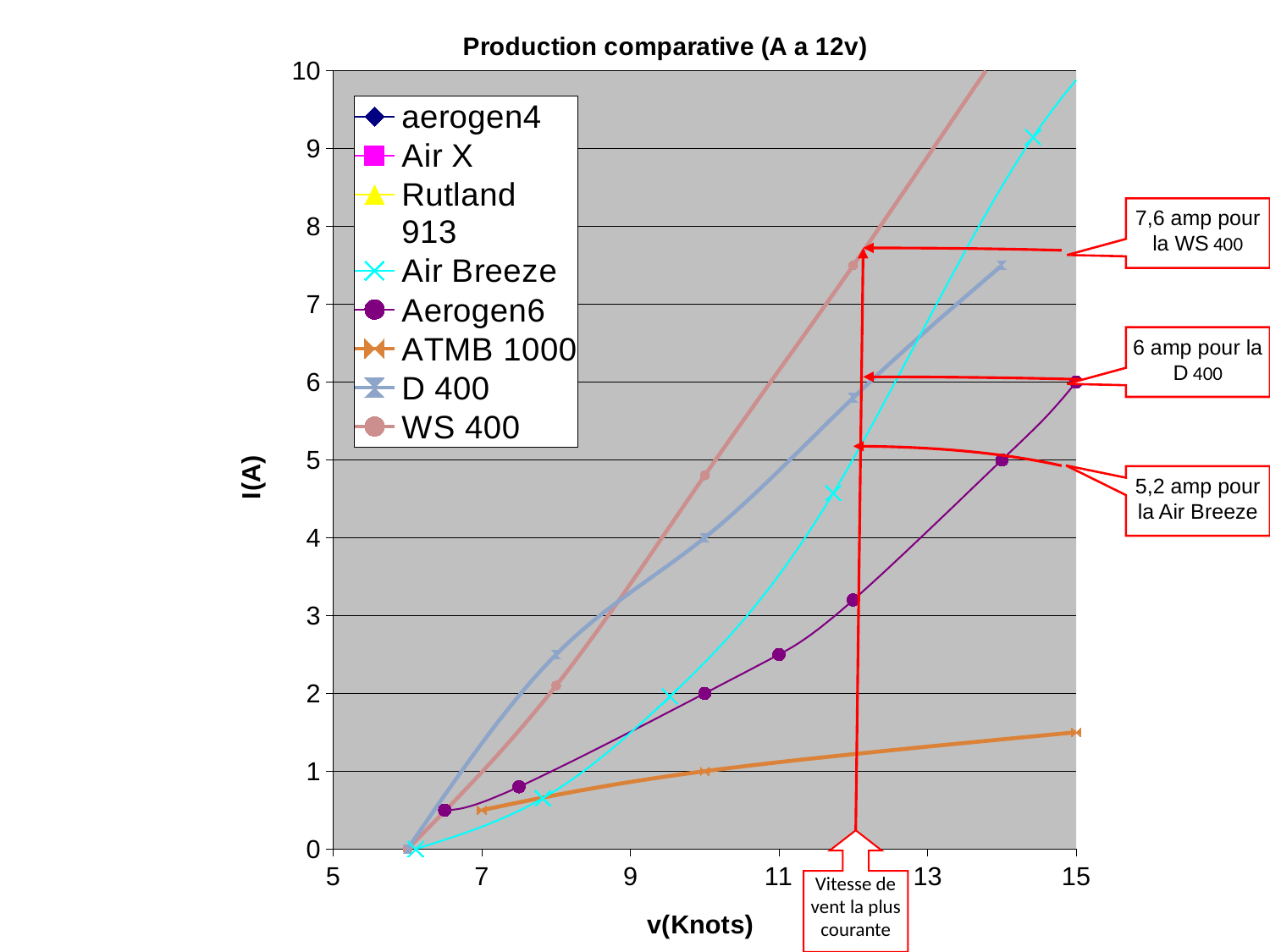
What is the difference between the annotated values for the WS 400 and the D 400 at the most common wind speed? 1,6 amp How many series does the legend list? 8 At 10 knots, which series is higher: WS 400 or D 400? WS 400 According to the annotation, how many amps does the D 400 produce at the most common wind speed? 6 amp Do the current values rise or fall as wind speed increases along the x axis? rise According to the annotation, how many amps does the Air Breeze produce at the most common wind speed? 5,2 amp According to the annotation, how many amps does the WS 400 produce at the most common wind speed? 7,6 amp Which series has the lowest current at 15 knots? ATMB 1000 Is the value for Aerogen6 at 15 knots greater or less than 5? greater Is the value for ATMB 1000 at 15 knots greater or less than 2? less What kind of chart is shown on the slide? line chart What is the title of the chart? Production comparative (A a 12v)